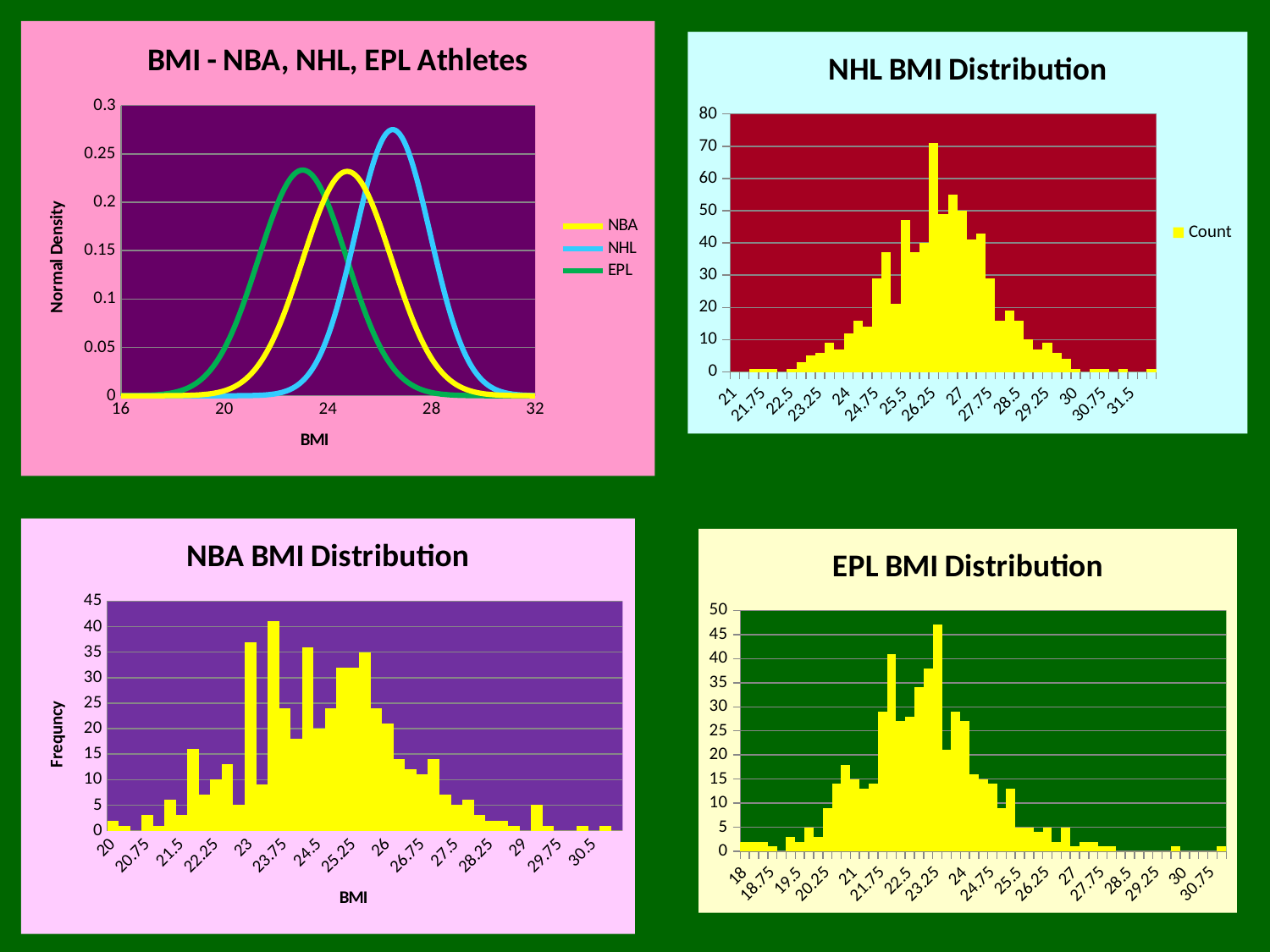
In the "EPL BMI Distribution" chart, is the tallest bar greater or less than 40? greater In the "BMI - NBA, NHL, EPL Athletes" chart, which series reaches the highest normal density? NHL In the "NHL BMI Distribution" chart, is the tallest bar greater or less than 60? greater In the "NBA BMI Distribution" chart, is the tallest bar greater or less than 35? greater What kind of chart is the "BMI - NBA, NHL, EPL Athletes" chart? line chart In the "BMI - NBA, NHL, EPL Athletes" chart, which series peaks at the lowest BMI value? EPL What is the only legend entry shown on the "NHL BMI Distribution" chart? Count What is the y-axis title of the "BMI - NBA, NHL, EPL Athletes" chart? Normal Density How many series does the legend of the "BMI - NBA, NHL, EPL Athletes" chart list? 3 What kind of chart is the "NHL BMI Distribution" chart? bar chart How many charts are shown on the slide? 4